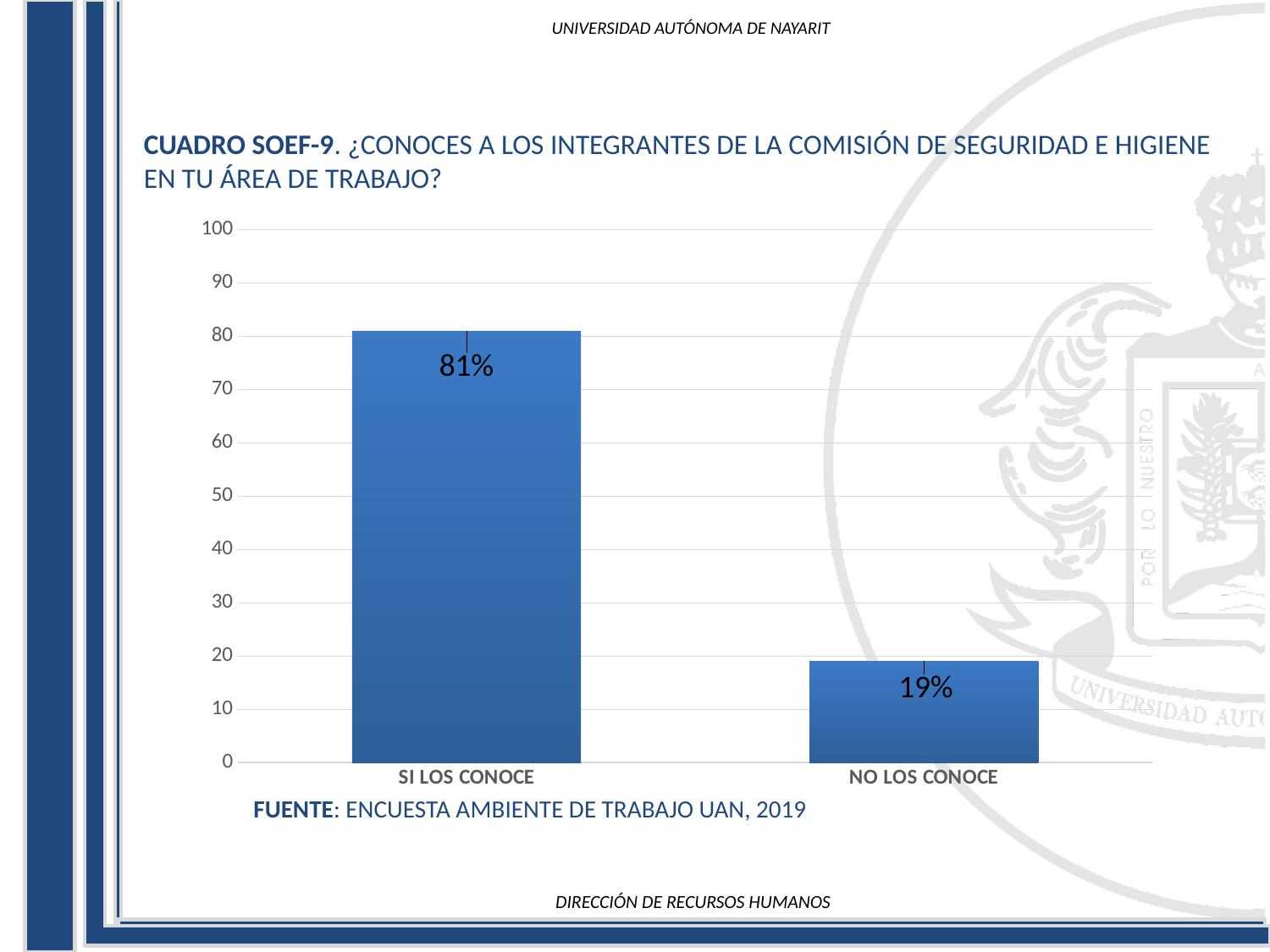
What is the value for SI LOS CONOCE? 81% What is the source cited below the chart? ENCUESTA AMBIENTE DE TRABAJO UAN, 2019 What is the highest value shown on the vertical axis? 100 What is the difference between the values for SI LOS CONOCE and NO LOS CONOCE? 62% Which is larger, the value for SI LOS CONOCE or NO LOS CONOCE? SI LOS CONOCE Is the value for NO LOS CONOCE greater or less than 30? less Which category has the highest value? SI LOS CONOCE How many categories are shown in the chart? 2 Is the value for SI LOS CONOCE greater or less than 70? greater What kind of chart is shown on the slide? bar chart Which category has the lowest value? NO LOS CONOCE What is the value for NO LOS CONOCE? 19%